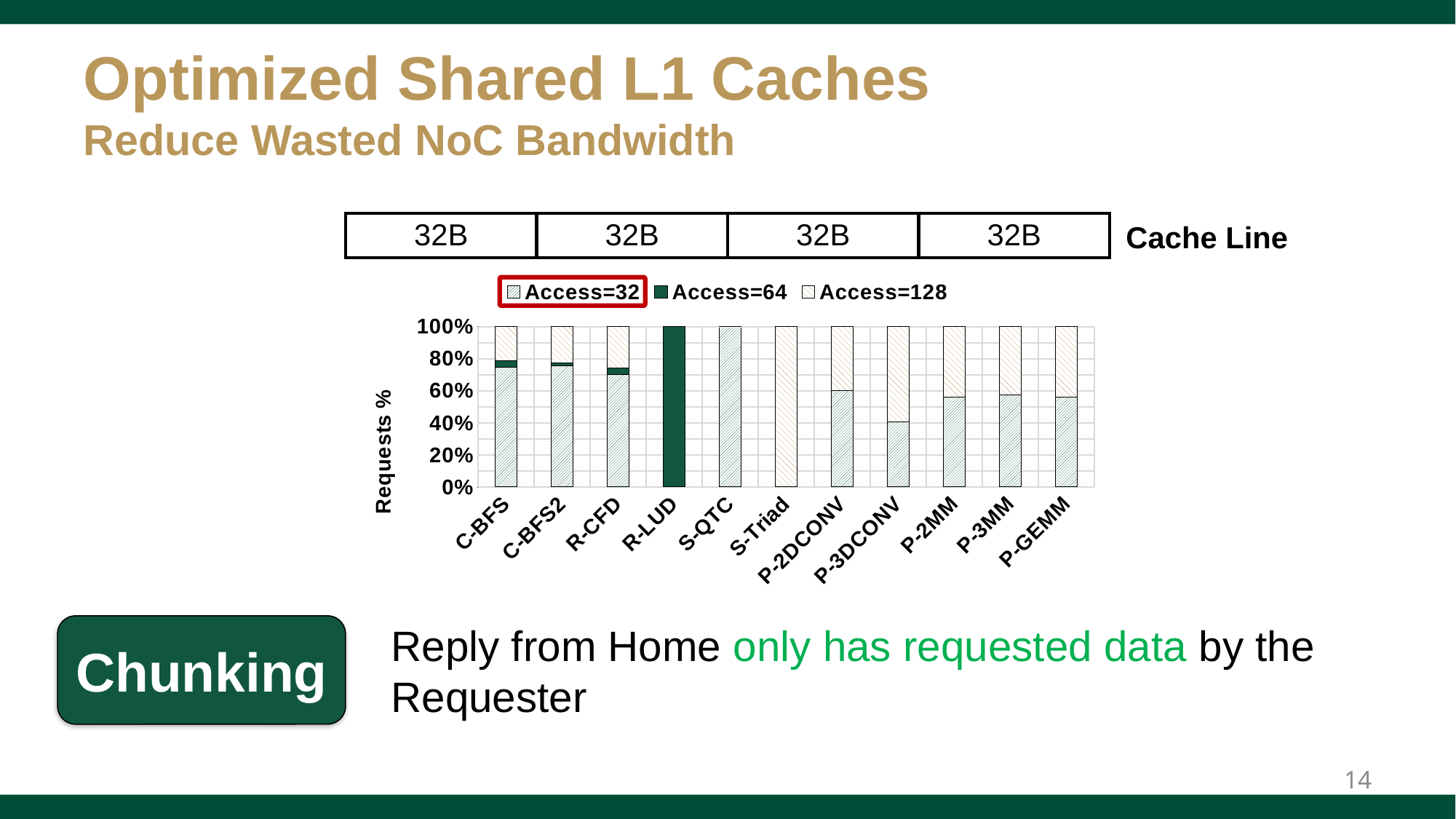
What kind of chart is shown on the slide? stacked bar chart How many series does the chart's legend list? 3 What share of requests for R-LUD are Access=64? 100% Is the Access=32 share for P-2MM greater or less than 80%? less What share of requests for S-Triad are Access=128? 100% How many benchmark categories are plotted along the x axis of the chart? 11 Which is larger for P-3DCONV: the Access=32 share or the Access=128 share? Access=128 Which benchmark has the largest Access=64 share? R-LUD Which legend entry is highlighted with a red box? Access=32 What is the label on the y axis of the chart? Requests % Is the Access=32 share for C-BFS greater or less than 60%? greater